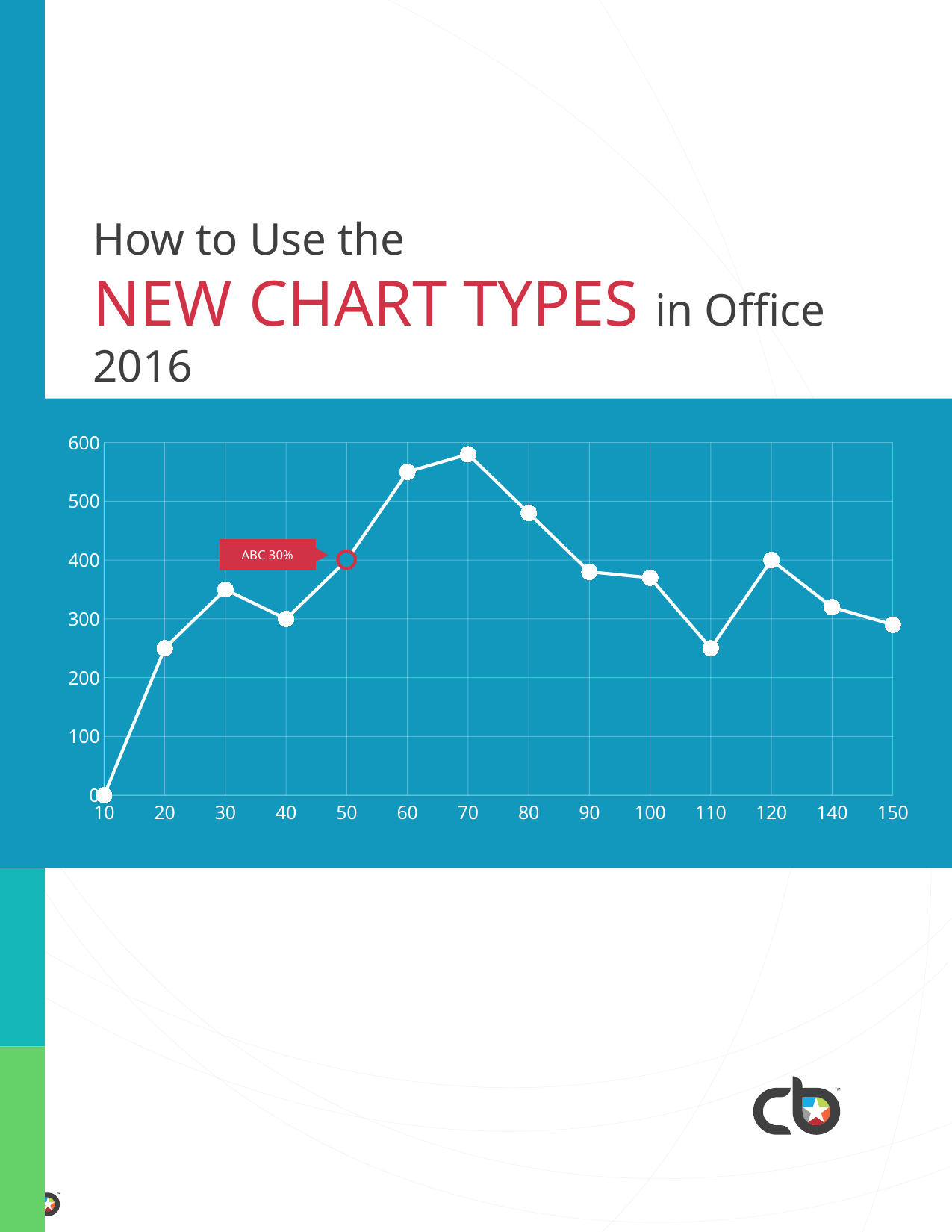
Is the value at x = 110 greater or less than 300? less What is the value at x = 120? 400 How many data points are plotted on the line? 14 At which x-axis value does the line reach its highest point? 70 What is the value at x = 40? 300 At which x-axis value does the line reach its lowest point? 10 Which has the larger value, x = 60 or x = 110? 60 What is the difference between the values at x = 50 and x = 40? 100 What kind of chart is shown on the slide? line chart Is the value at x = 70 greater or less than 500? greater What is the value at x = 50, the point marked with the callout? 400 What text is shown in the red callout label attached to the point at x = 50? ABC 30%